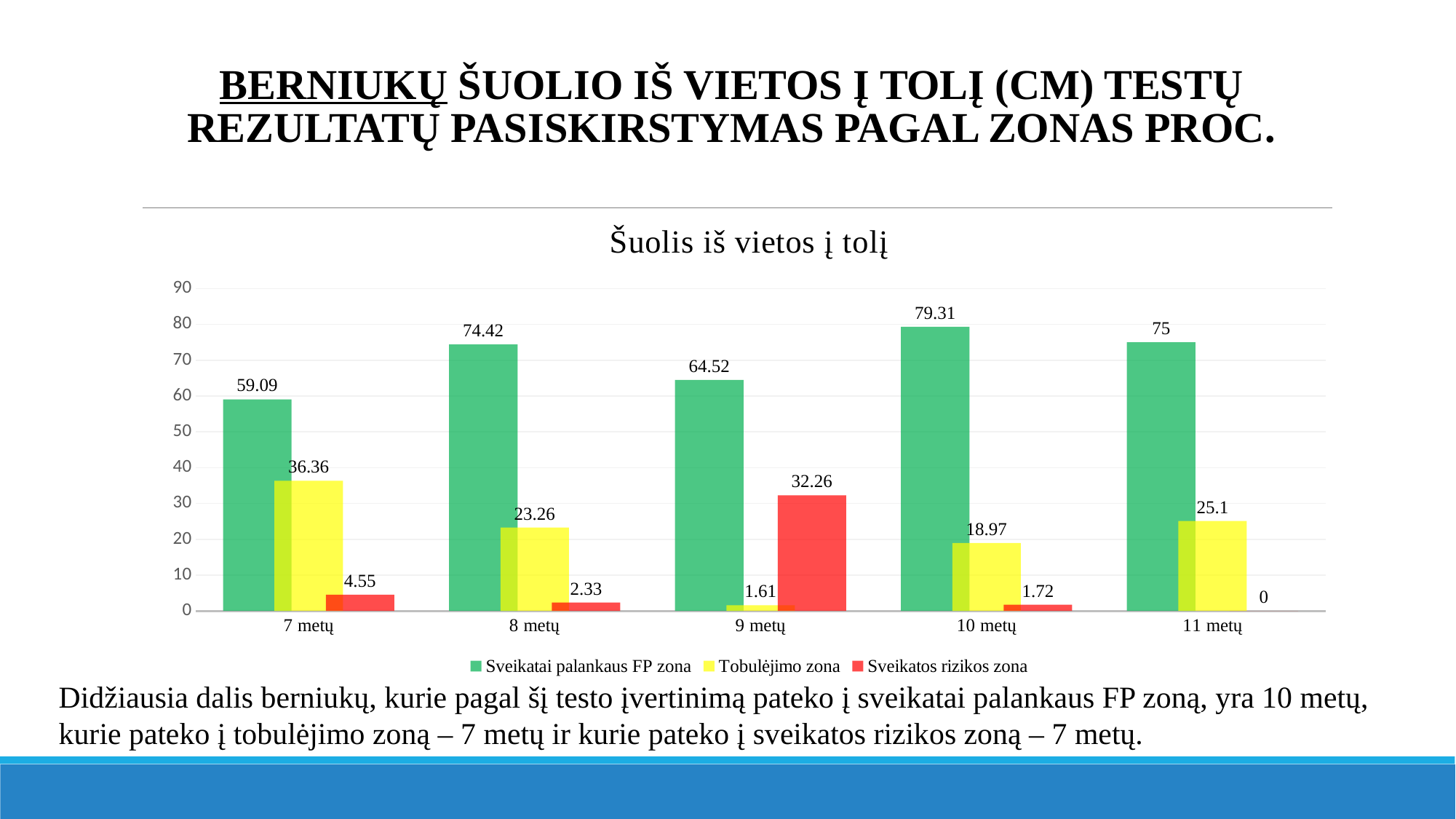
What is the value for Sveikatos rizikos zona for 9 metų? 32.26 Which age group has the highest value for Sveikatai palankaus FP zona? 10 metų Is the value for Sveikatai palankaus FP zona for 9 metų greater or less than 70? less What is the value for Sveikatos rizikos zona for 11 metų? 0 What is the value for Sveikatai palankaus FP zona for 10 metų? 79.31 What is the value for Tobulėjimo zona for 7 metų? 36.36 What is the difference between the Sveikatai palankaus FP zona values for 10 metų and 7 metų? 20.22 How many age groups are shown on the x axis? 5 What type of chart is shown on the slide? bar chart How many series does the legend list? 3 Which age group has the lowest value for Tobulėjimo zona? 9 metų Which is larger: the Tobulėjimo zona value for 8 metų or for 11 metų? 11 metų